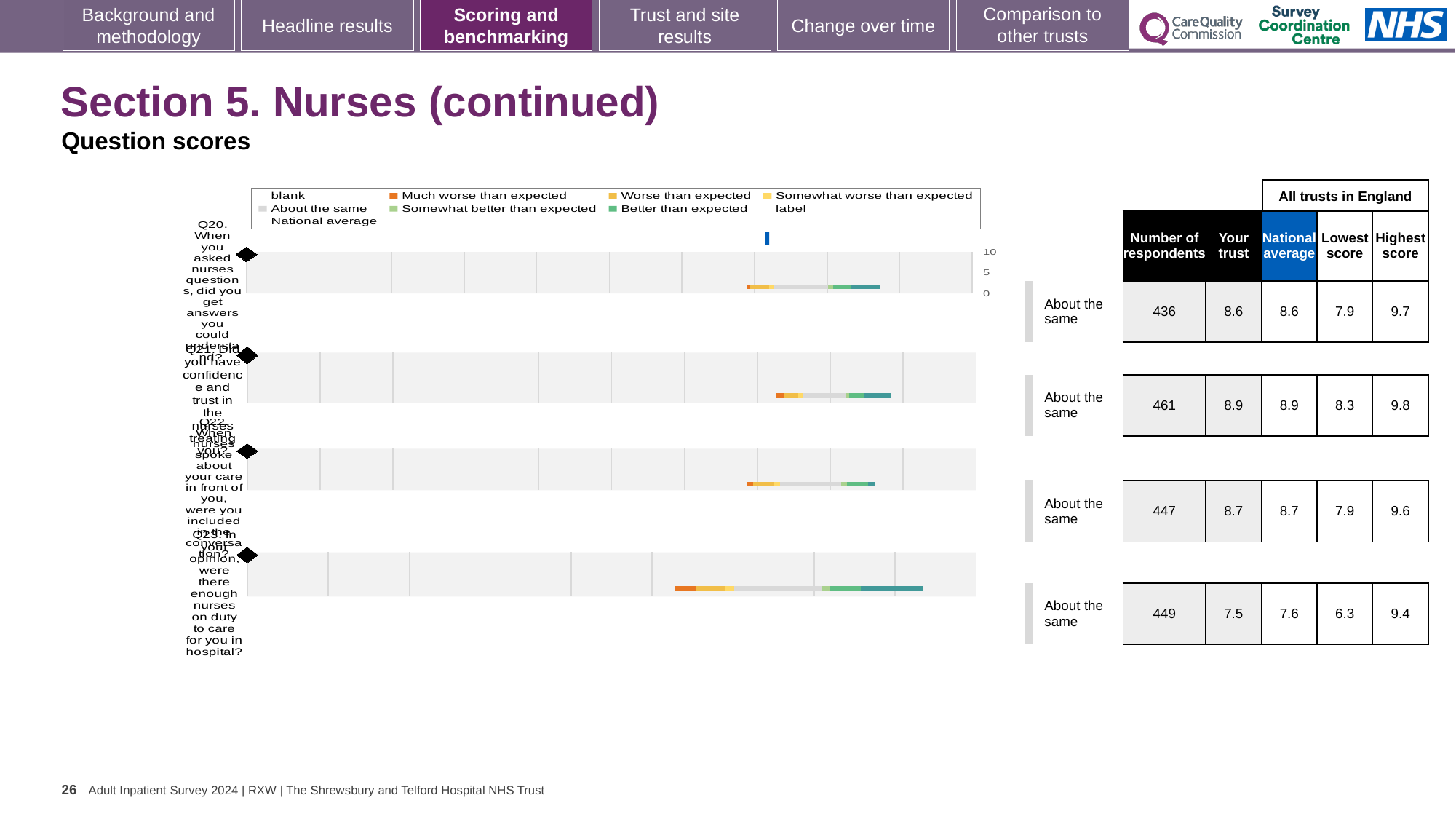
Which question has the lowest 'Your trust' score? Q23 For Q21 (did you have confidence and trust in the nurses treating you?), how many respondents are there? 461 What benchmark category is shown for Q23? About the same For Q23, what is the difference between the highest score and the lowest score across all trusts in England? 3.1 How many questions (Q20 to Q23) are plotted on the slide? 4 For Q23 (were there enough nurses on duty to care for you in hospital?), what is the national average score? 7.6 What kind of chart is used to show the question scores on this slide? bar chart Which question has the highest 'Your trust' score? Q21 For Q20 (when you asked nurses questions, did you get answers you could understand?), what is the 'Your trust' score? 8.6 Which has the larger 'Your trust' score, Q20 or Q22? Q22 Is the 'Your trust' score for Q23 greater or less than 5 on the chart axis? greater What colour does the legend use for 'Much worse than expected'? orange